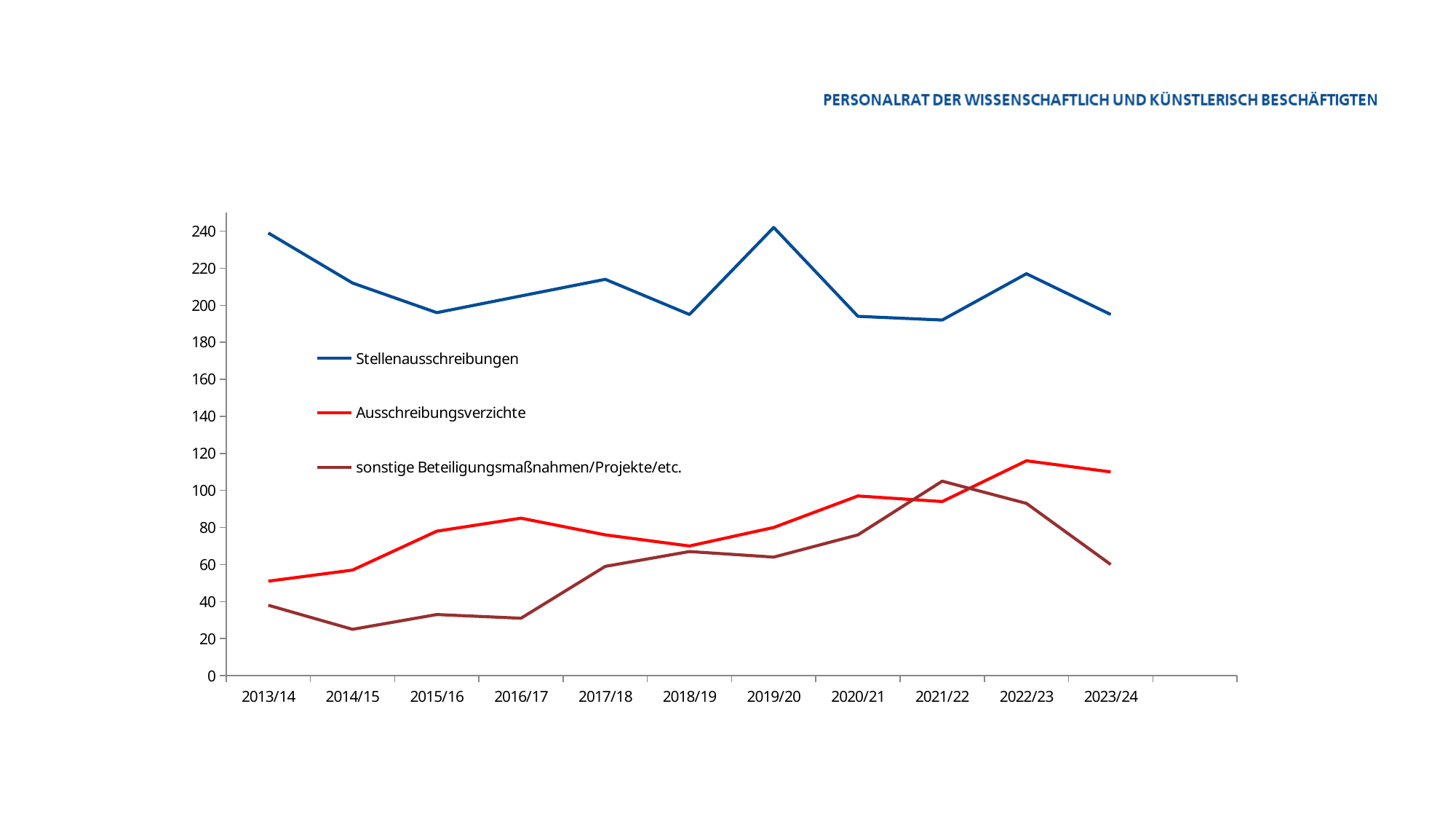
How many academic years are shown on the x axis? 11 Is the value for sonstige Beteiligungsmaßnahmen/Projekte/etc. in 2014/15 greater or less than 40? less In which year is the sonstige Beteiligungsmaßnahmen/Projekte/etc. line at its lowest? 2014/15 In which year is the Ausschreibungsverzichte line at its lowest? 2013/14 In which year does the sonstige Beteiligungsmaßnahmen/Projekte/etc. line reach its peak? 2021/22 Does the Stellenausschreibungen line rise or fall from 2013/14 to 2015/16? fall How many series does the legend list? 3 What kind of chart is shown on the slide? line chart In which year is the Ausschreibungsverzichte line at its highest? 2022/23 Is the value for Stellenausschreibungen in 2013/14 greater or less than 220? greater In 2023/24, which is larger: Ausschreibungsverzichte or sonstige Beteiligungsmaßnahmen/Projekte/etc.? Ausschreibungsverzichte Is the value for Ausschreibungsverzichte in 2023/24 greater or less than 100? greater